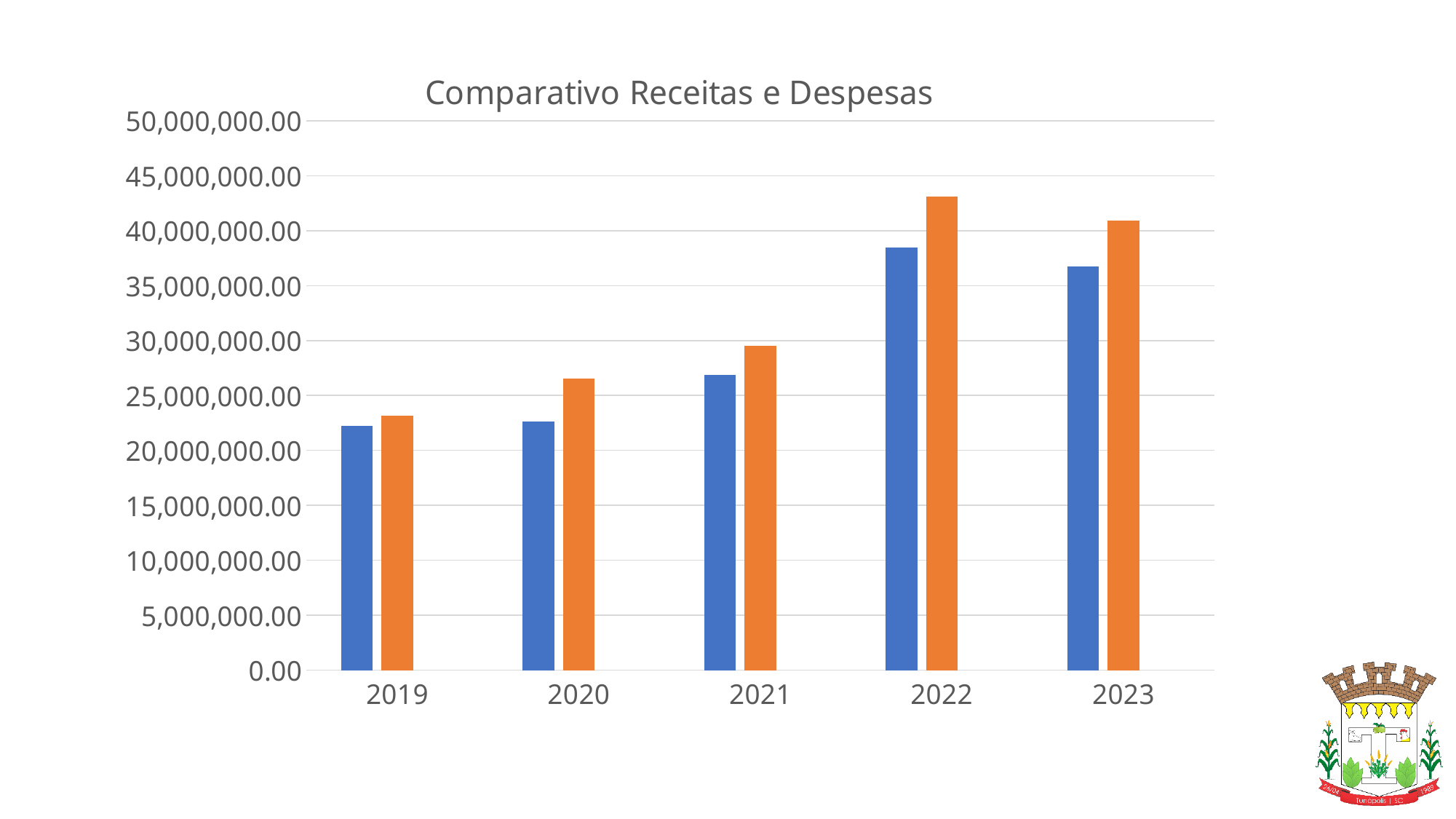
Do the orange bars rise or fall from 2019 to 2022? Rise Is the blue bar for 2019 greater or less than 25,000,000.00? less What kind of chart is shown on the slide? Bar chart In 2020, which bar is taller, the blue bar or the orange bar? The orange bar Which year has the tallest blue bar? 2022 How many years are shown on the x axis of the chart? 5 What is the title of the chart? Comparativo Receitas e Despesas Is the blue bar for 2023 greater or less than 35,000,000.00? greater Which year has the tallest orange bar? 2022 How many bars are shown for each year in the chart? 2 Is the orange bar for 2022 greater or less than 40,000,000.00? greater Which year has the shortest orange bar? 2019